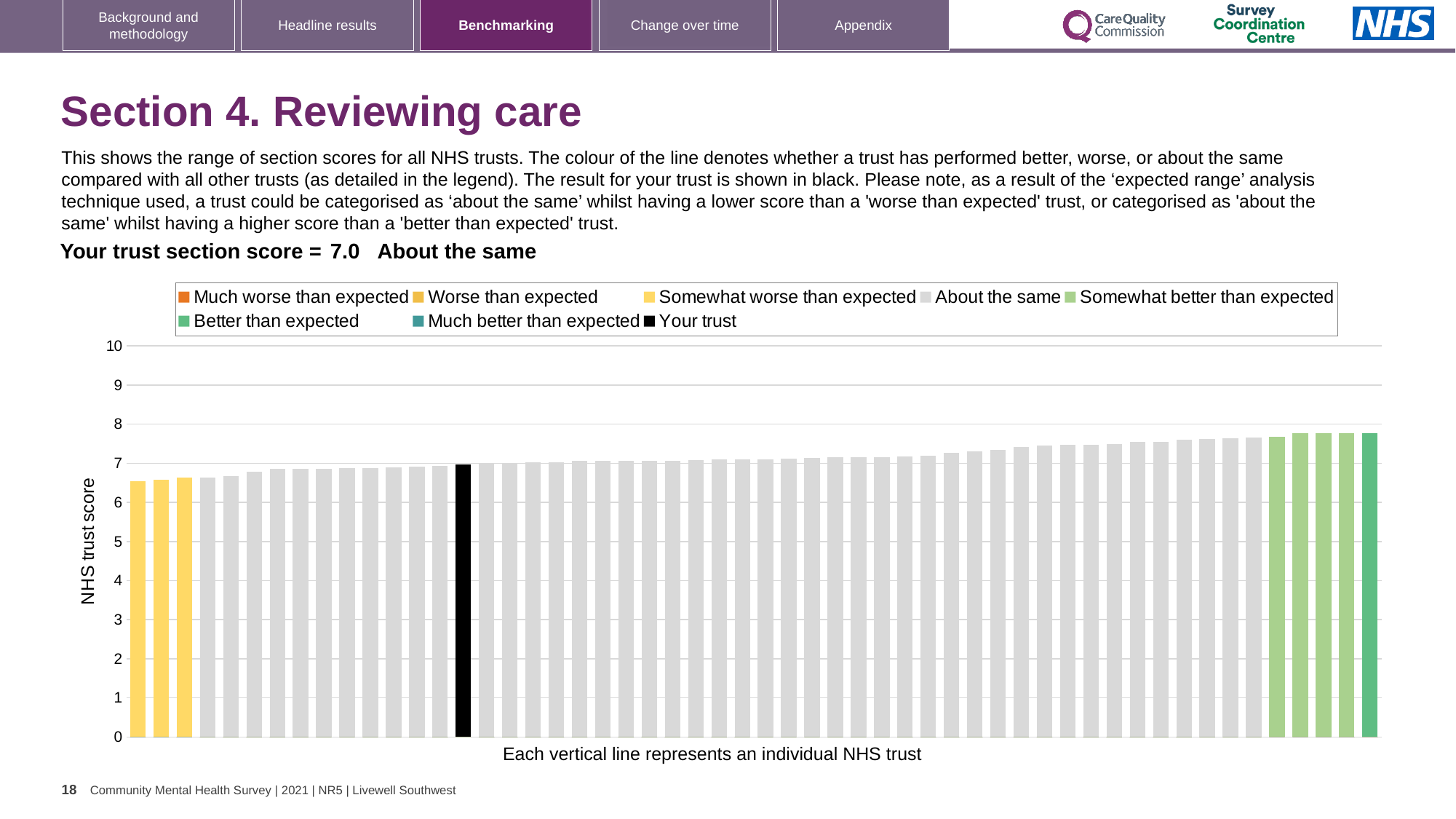
What is the label on the vertical axis of the chart? NHS trust score What colour is the bar representing your trust? black What is the section score for your trust shown on the slide? 7.0 Is the highest bar on the chart greater or less than 8? less How many bars are coloured yellow (Somewhat worse than expected)? 3 Do the bar values rise or fall from left to right along the x axis? rise Is the lowest bar on the chart greater or less than 6? greater What kind of chart is shown on the slide? bar chart How many entries does the chart legend list? 8 Is the value for your trust (the black bar) greater or less than 5? greater Which category is your trust placed in for this section? About the same